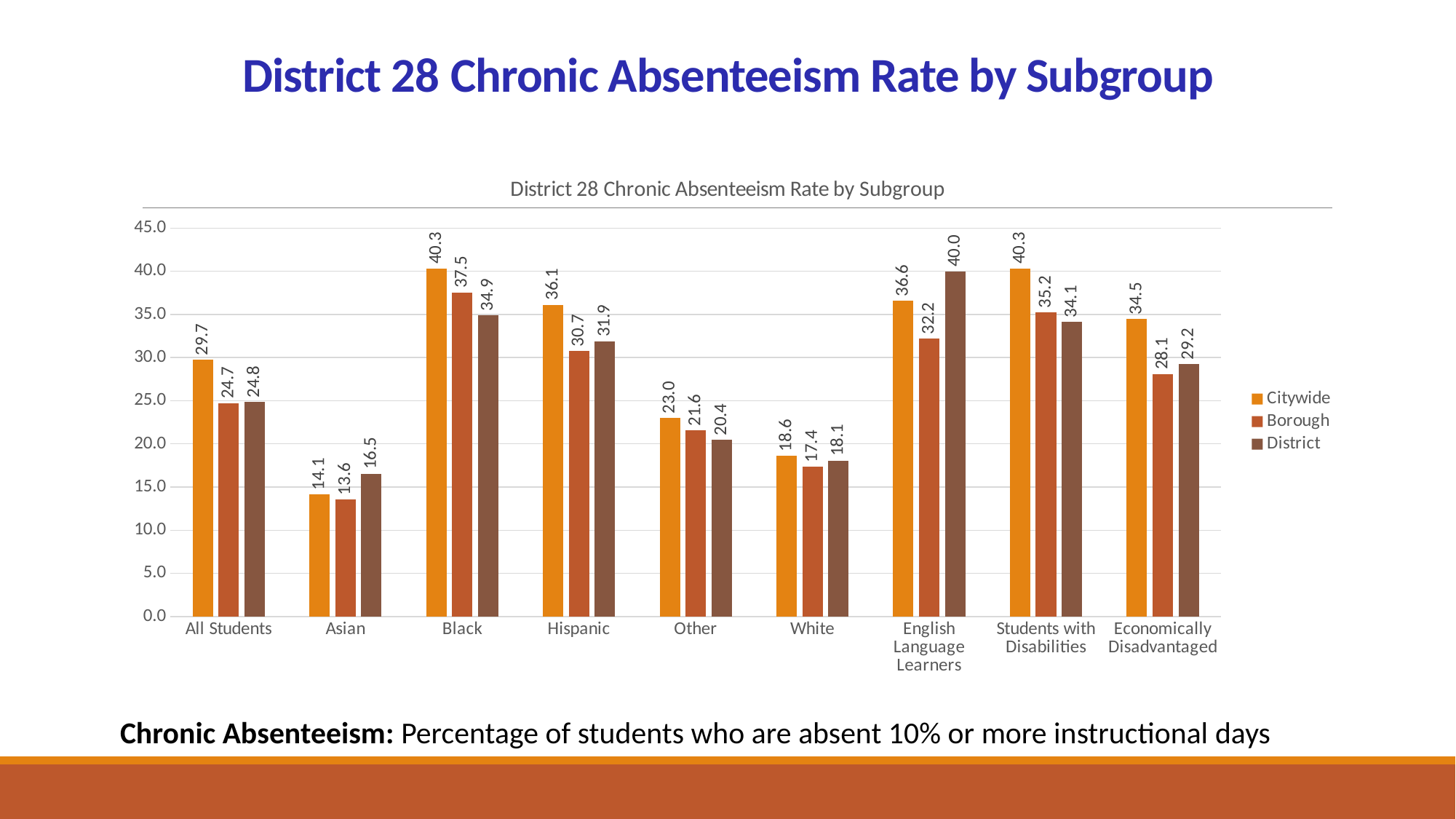
How many subgroups are shown on the x axis? 9 What kind of chart is shown on the slide? Bar chart What is the Borough value for Economically Disadvantaged students? 28.1 Which subgroup has the highest Borough value? Black What is the Citywide value for Hispanic students? 36.1 What is the difference between the District and Borough values for English Language Learners? 7.8 How many series does the legend list? 3 What is the difference between the Citywide and District values for Black students? 5.4 Which subgroup has the lowest Borough value? Asian For Asian students, which is larger: the Citywide value or the District value? District Which subgroup has the highest District value? English Language Learners What is the District value for English Language Learners? 40.0